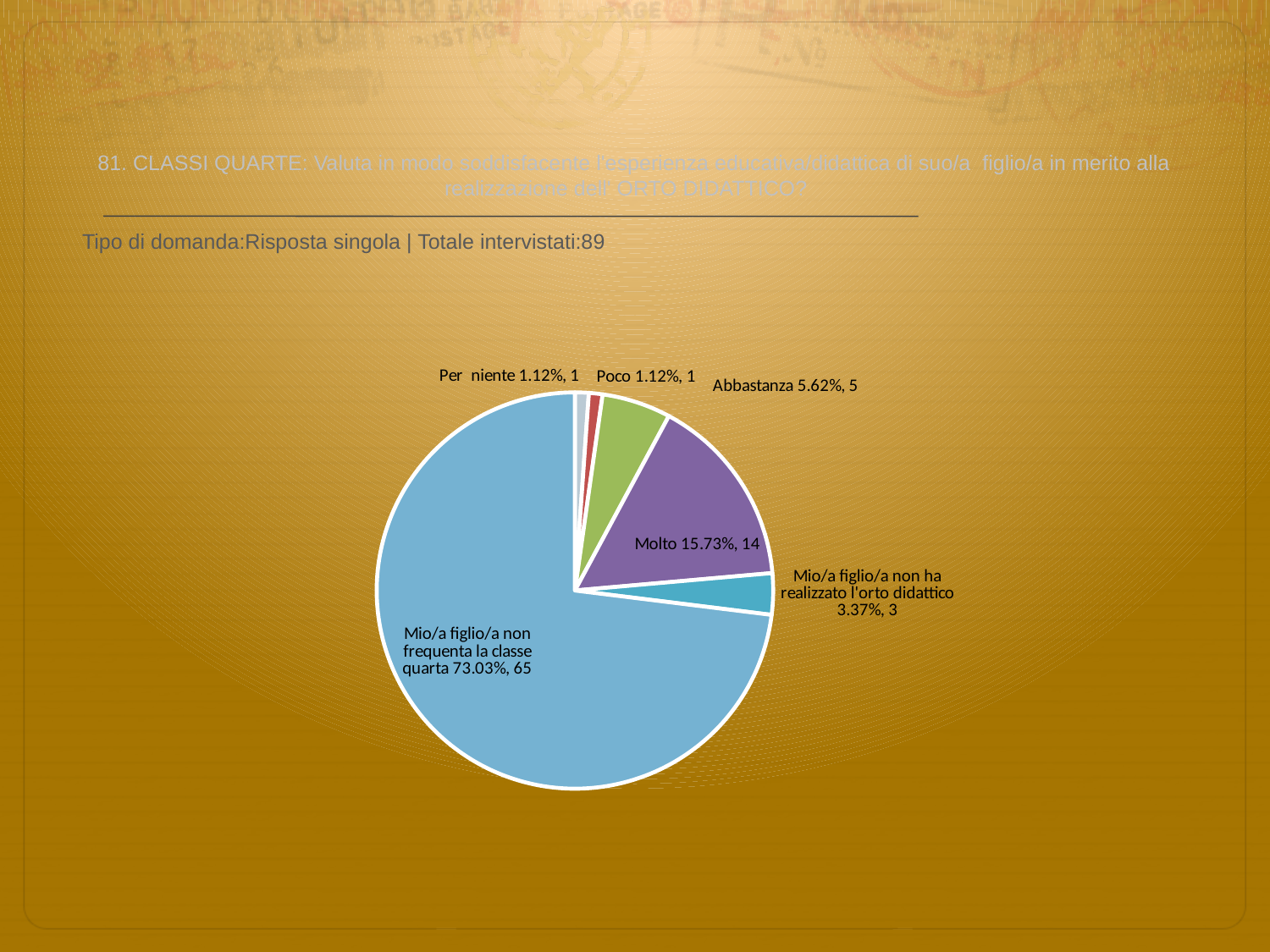
What is the difference in respondent count between "Molto" and "Abbastanza"? 9 How many respondents answered "Mio/a figlio/a non ha realizzato l'orto didattico"? 3 Which category has the largest share of the pie? Mio/a figlio/a non frequenta la classe quarta Which is larger: the share for "Molto" or the share for "Abbastanza"? Molto What is the total number of respondents stated on the slide? 89 What percentage is shown for "Poco"? 1.12% What percentage of respondents answered "Molto"? 15.73% How many respondents answered "Abbastanza"? 5 What colour is the slice for "Molto"? purple What percentage is shown for "Mio/a figlio/a non frequenta la classe quarta"? 73.03% How many slices does the pie chart have? 6 What kind of chart is shown on the slide? pie chart